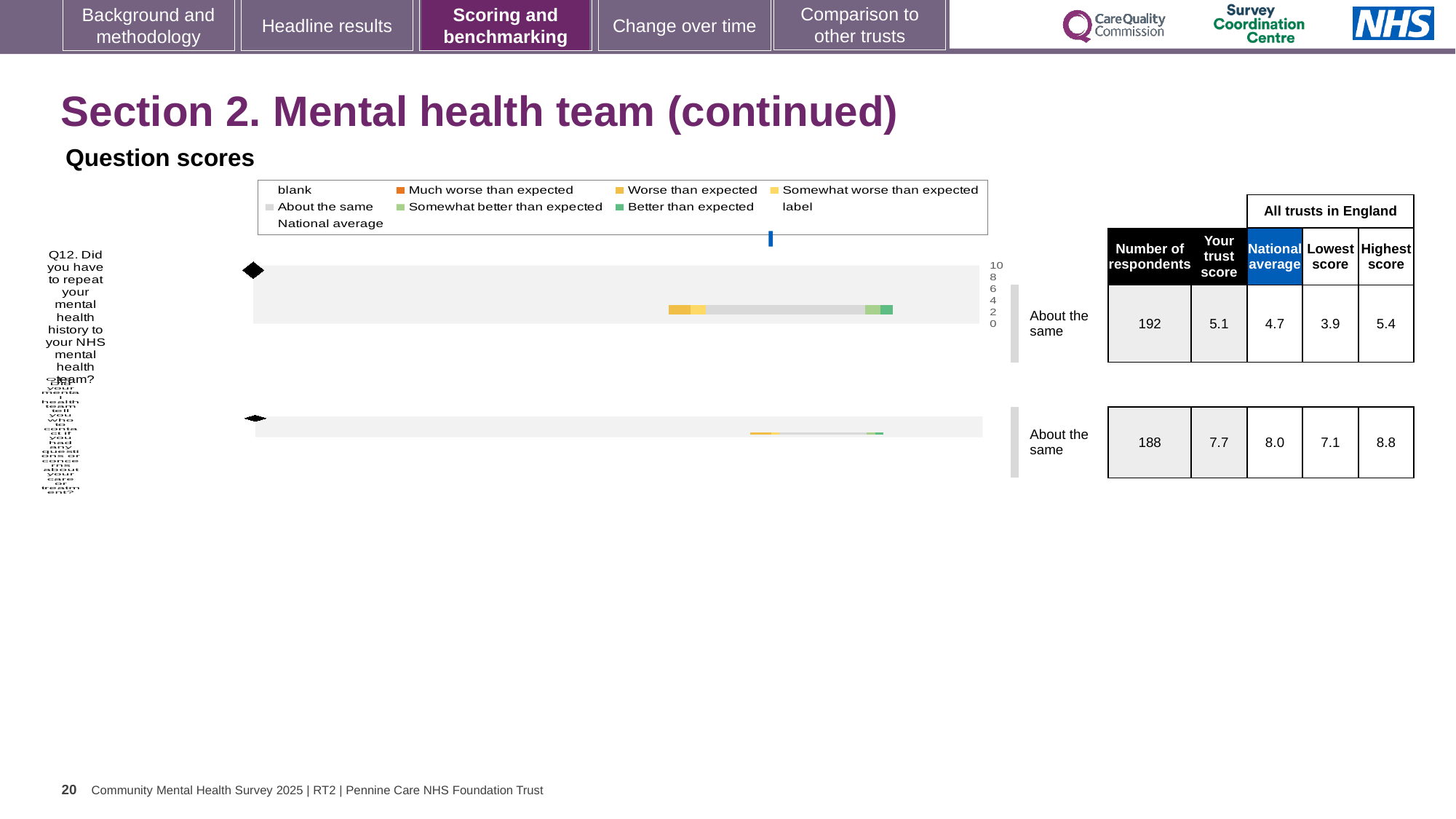
For the Q12 chart (repeating your mental health history), what is your trust score shown in the table? 5.1 For the Q12 chart (repeating your mental health history), how many respondents are listed? 192 For the Q12 chart (repeating your mental health history), what is the lowest score among all trusts in England? 3.9 For the Q12 chart (repeating your mental health history), what is the national average score? 4.7 For the Q12 chart (repeating your mental health history), which is larger: your trust score or the national average? Your trust score For the lower chart on the slide (second row of the table), what is the difference between the national average and your trust score? 0.3 What kind of chart is used to show the question scores on this slide? Bar chart For the Q12 chart (repeating your mental health history), what is the difference between the highest and lowest scores among all trusts in England? 1.5 For the lower chart on the slide (second row of the table), what is your trust score? 7.7 For the lower chart on the slide (second row of the table), what is the national average score? 8.0 For the lower chart on the slide (second row of the table), which is larger: your trust score or the national average? National average For the Q12 chart (repeating your mental health history), what is the highest score among all trusts in England? 5.4